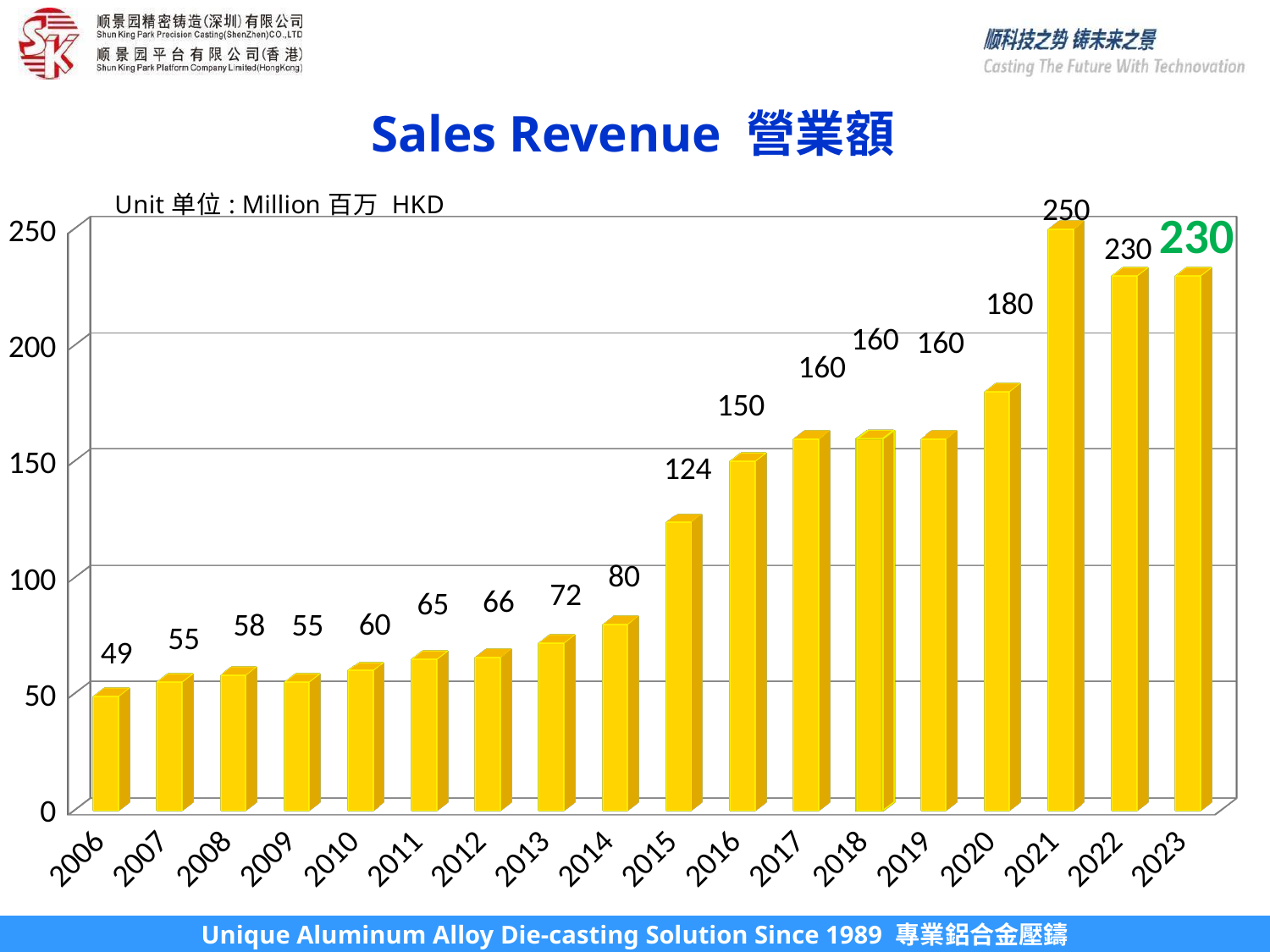
What is the difference between the sales revenue in 2016 and in 2015? 26 Which year has the lowest sales revenue? 2006 What kind of chart is shown on the slide? Bar chart What is the sales revenue value for 2023? 230 What unit is the sales revenue measured in, according to the chart? Million HKD Which year has a larger sales revenue, 2014 or 2020? 2020 How many years are shown on the x axis of the chart? 18 Do the sales revenue values generally rise or fall from 2006 to 2021? Rise Which year has the highest sales revenue? 2021 What is the sales revenue value for 2015? 124 What is the difference between the sales revenue in 2021 and in 2022? 20 What is the sales revenue value for 2006? 49